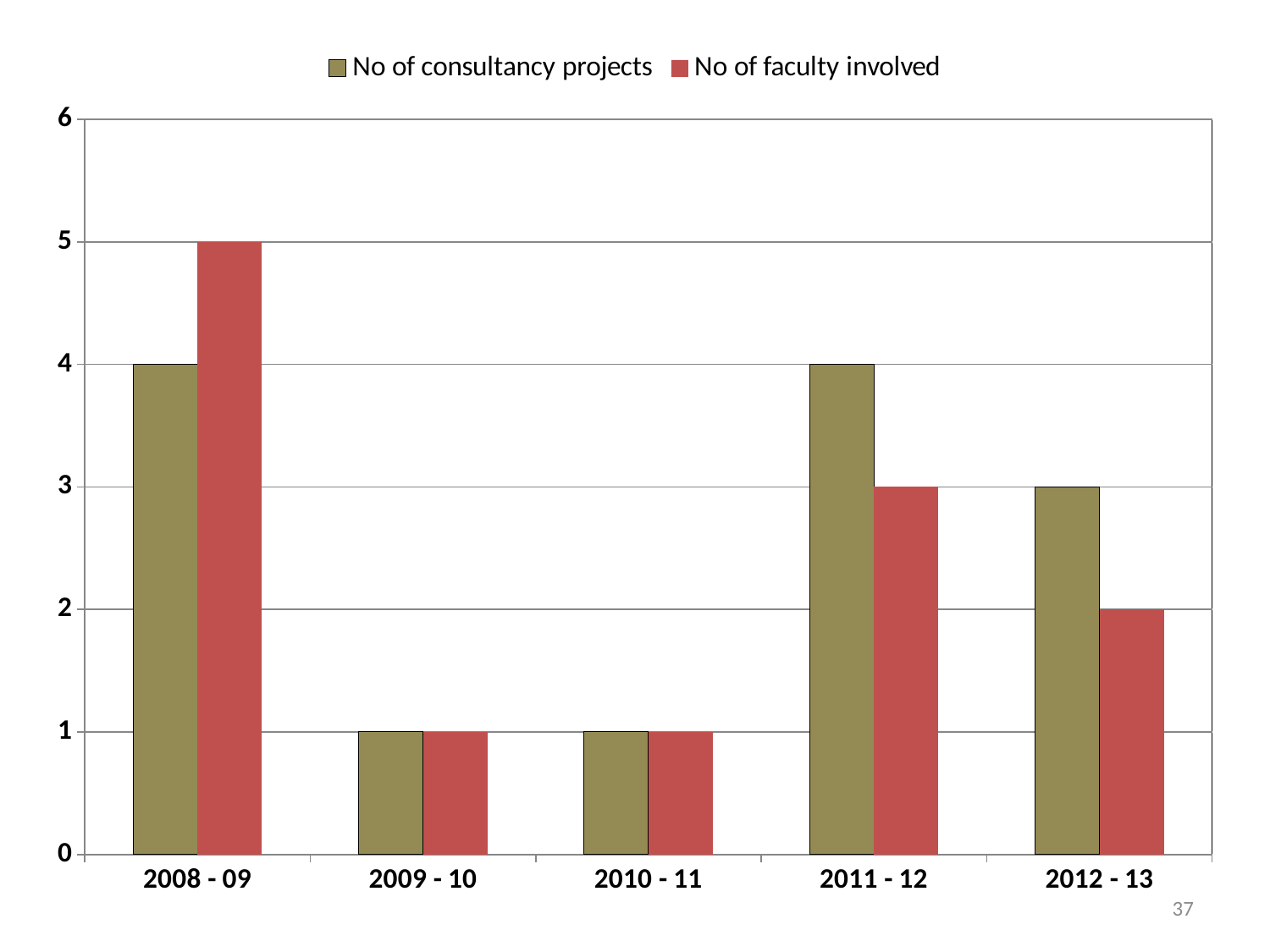
In 2011 - 12, which is larger: the number of consultancy projects or the number of faculty involved? No of consultancy projects Which year has the lowest number of faculty involved? 2009 - 10 and 2010 - 11 What is the number of consultancy projects in 2012 - 13? 3 Which series is shown in red? No of faculty involved What kind of chart is shown on the slide? bar chart How many year categories are shown on the x axis? 5 What is the number of consultancy projects in 2011 - 12? 4 Which year has the highest number of faculty involved? 2008 - 09 What is the difference between the number of consultancy projects and the number of faculty involved in 2012 - 13? 1 Is the number of faculty involved in 2008 - 09 greater or less than 4? greater How many series does the legend list? 2 What is the number of faculty involved in 2008 - 09? 5